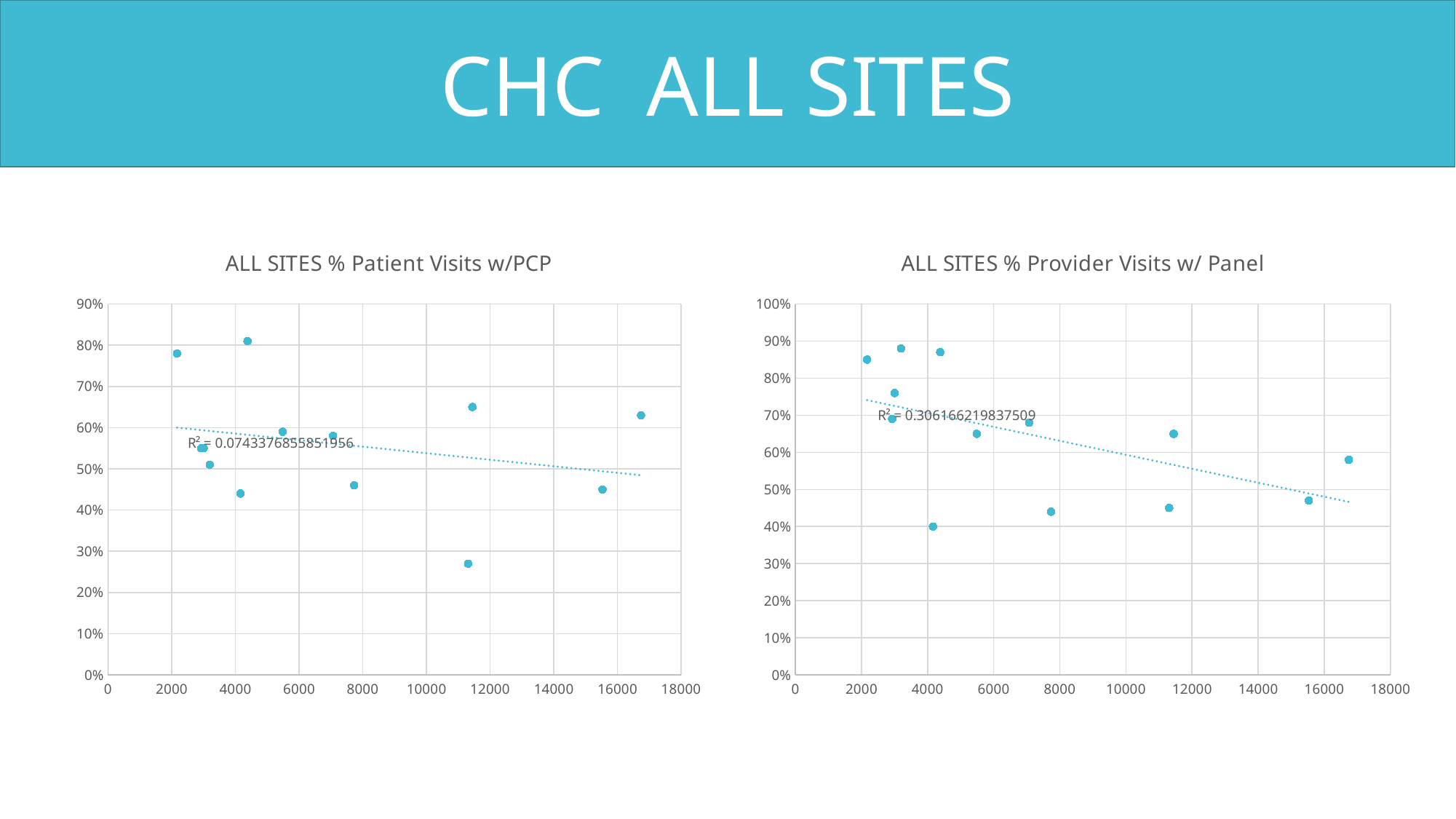
In the 'ALL SITES % Patient Visits w/PCP' chart, is the lowest plotted point greater or less than 30%? less What kind of chart is the 'ALL SITES % Provider Visits w/ Panel' chart? scatter chart In the 'ALL SITES % Provider Visits w/ Panel' chart, what R² value is printed next to the trendline? R² = 0.306166219837509 In the 'ALL SITES % Patient Visits w/PCP' chart, what R² value is printed next to the trendline? R² = 0.0743376855851956 What kind of chart is the 'ALL SITES % Patient Visits w/PCP' chart? scatter chart In the 'ALL SITES % Provider Visits w/ Panel' chart, is the highest plotted point greater or less than 80%? greater In the 'ALL SITES % Provider Visits w/ Panel' chart, is the point plotted furthest to the right (near x = 17000) greater or less than 50%? greater How many data points are plotted in the 'ALL SITES % Patient Visits w/PCP' chart? 13 In the 'ALL SITES % Provider Visits w/ Panel' chart, does the dotted trendline rise or fall as the x-axis value increases? fall In the 'ALL SITES % Patient Visits w/PCP' chart, does the dotted trendline rise or fall as the x-axis value increases? fall What is the highest value shown on the y-axis of the 'ALL SITES % Provider Visits w/ Panel' chart? 100%